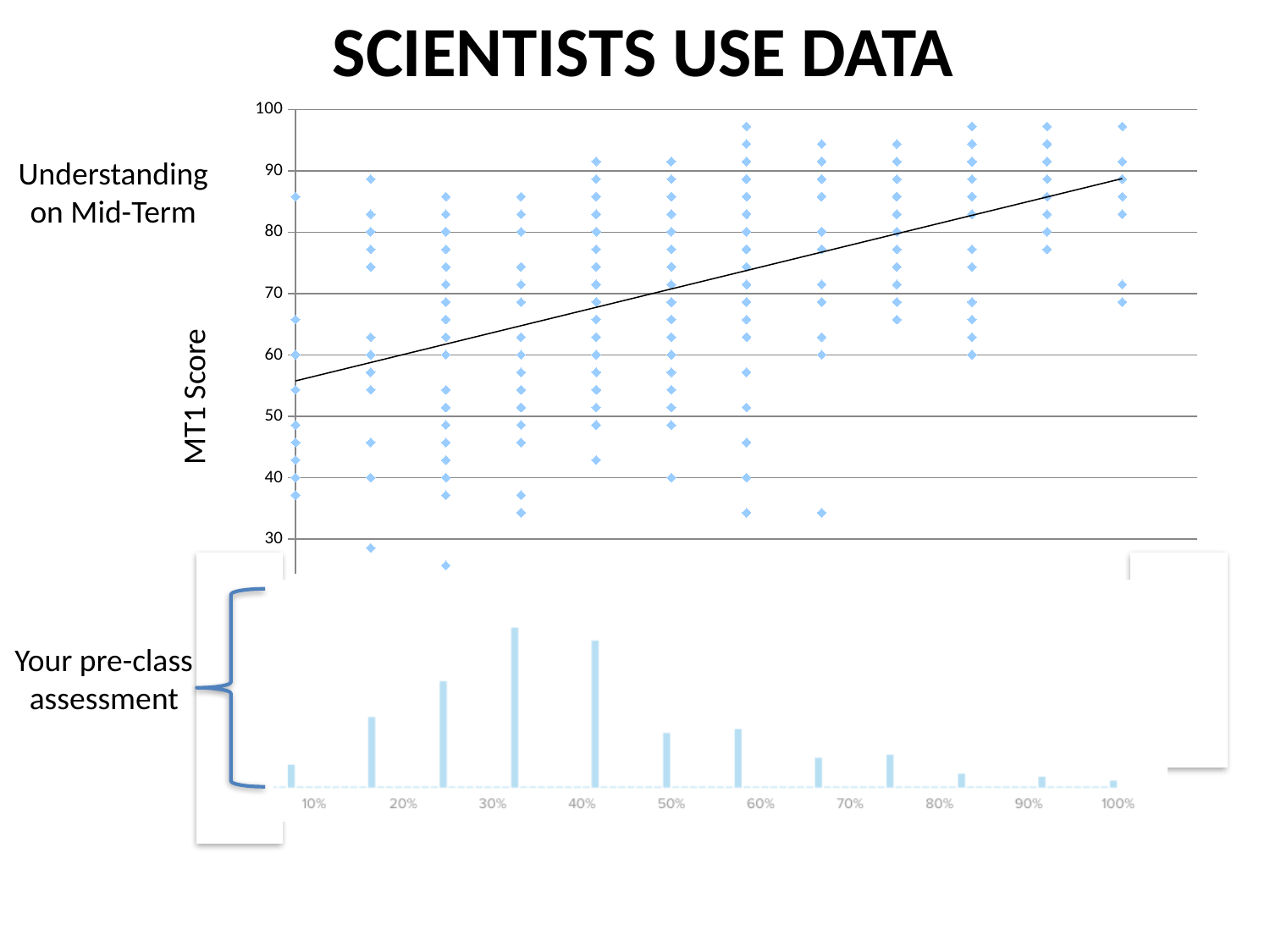
What is the y-axis label of the upper scatter plot? MT1 Score In the upper scatter plot, what is the highest value shown on the y axis? 100 In the upper scatter plot, is the trend line's value at the left end (around 10%) greater or less than 60? less How many percentage labels are shown on the x axis of the lower bar chart? 10 What kind of chart is the lower chart on the slide? bar chart In the upper scatter plot, what is the lowest value labelled on the y axis? 30 What is the title of the slide? SCIENTISTS USE DATA In the upper scatter plot, is the trend line's value at 100% on the x axis greater or less than 80? greater What kind of chart is the upper chart on the slide? scatter plot In the upper scatter plot, does the fitted trend line rise or fall as the pre-class assessment score increases along the x axis? rises